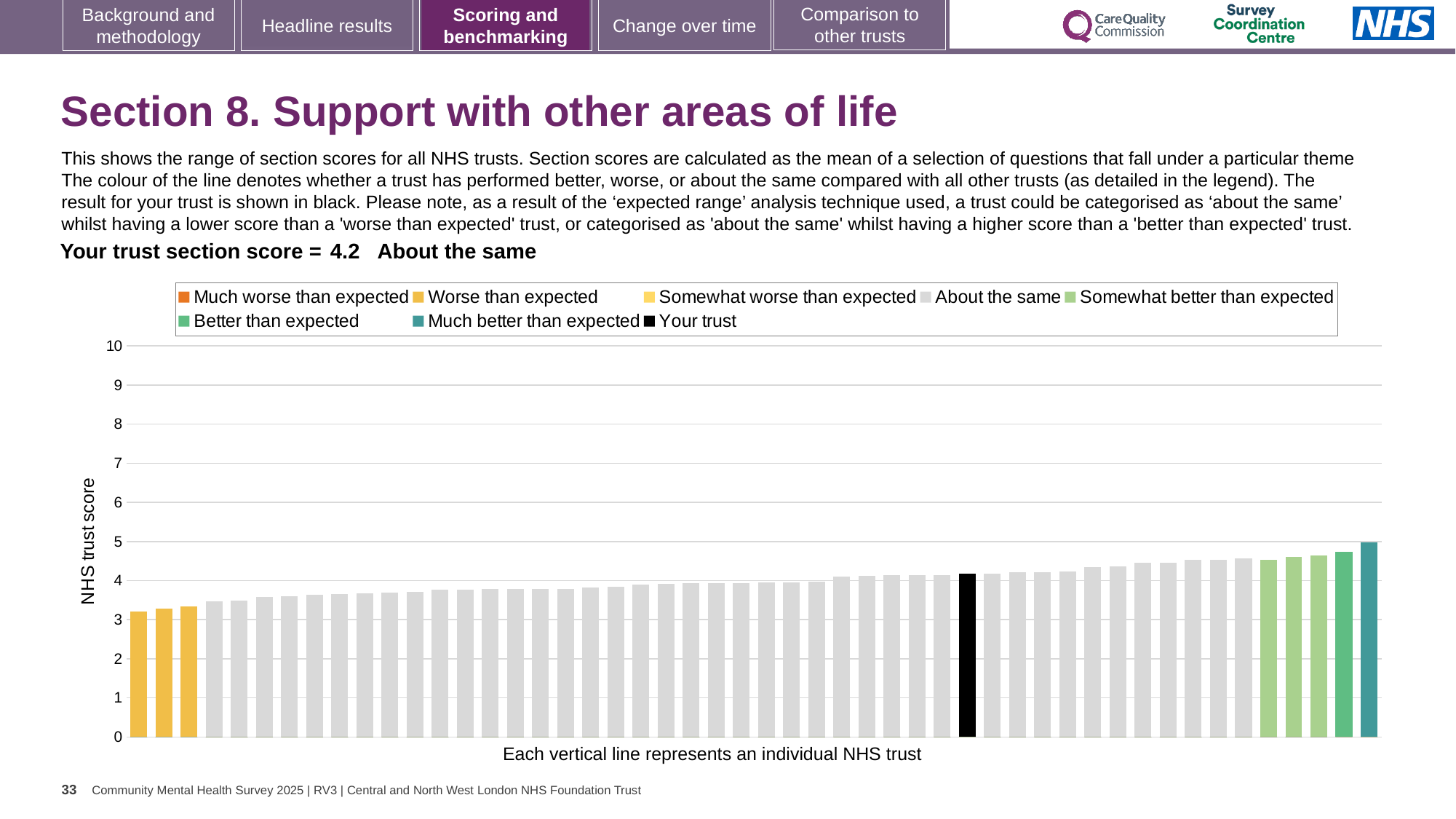
Do the bar values rise or fall from left to right along the x axis? rise What is the label on the vertical axis of the chart? NHS trust score Which legend category does the tallest bar belong to? Much better than expected Is the value of the black 'Your trust' bar greater or less than 4? greater Is the value of the tallest bar greater or less than 4? greater How many bars are coloured as 'Somewhat better than expected' (light green)? 3 What kind of chart is shown on the slide? bar chart How many entries does the chart legend list? 8 What is the section score for your trust? 4.2 How many bars are coloured as 'Worse than expected' (yellow)? 3 Which category is your trust placed in for this section? About the same Is the value of the leftmost (lowest) bar greater or less than 4? less